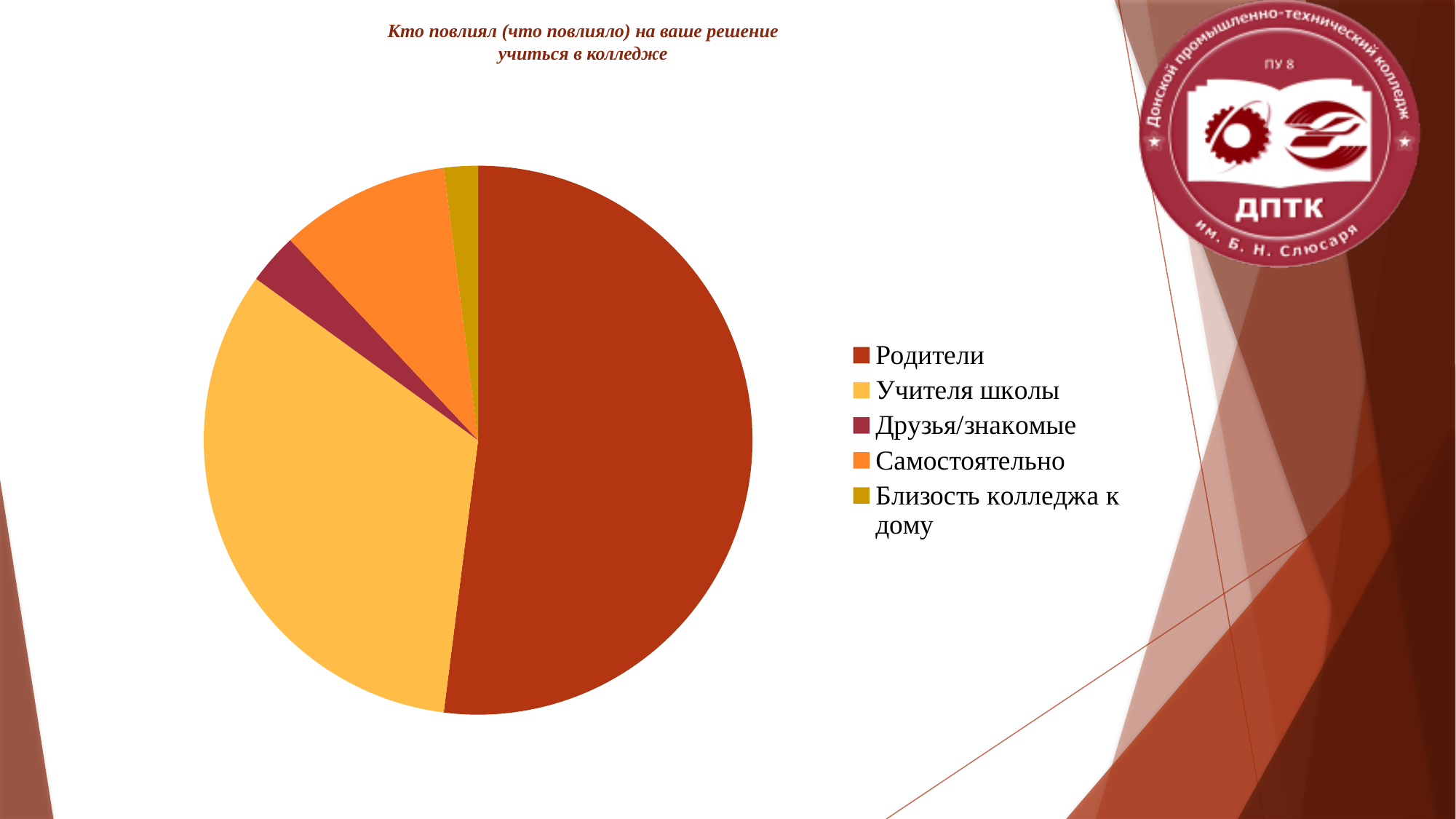
Which slice is larger: Учителя школы or Самостоятельно? Учителя школы What kind of chart is shown on the slide? pie chart Which category is shown in the yellow (light orange) colour in the legend? Учителя школы Which category has the largest slice of the pie chart? Родители How many entries does the legend of the pie chart list? 5 Which category has the second-largest slice of the pie chart? Учителя школы Which slice is larger: Самостоятельно or Друзья/знакомые? Самостоятельно What is the title of the chart? Кто повлиял (что повлияло) на ваше решение учиться в колледже Which slice is larger: Родители or Учителя школы? Родители How many categories (slices) does the pie chart have? 5 Which category has the smallest slice of the pie chart? Близость колледжа к дому